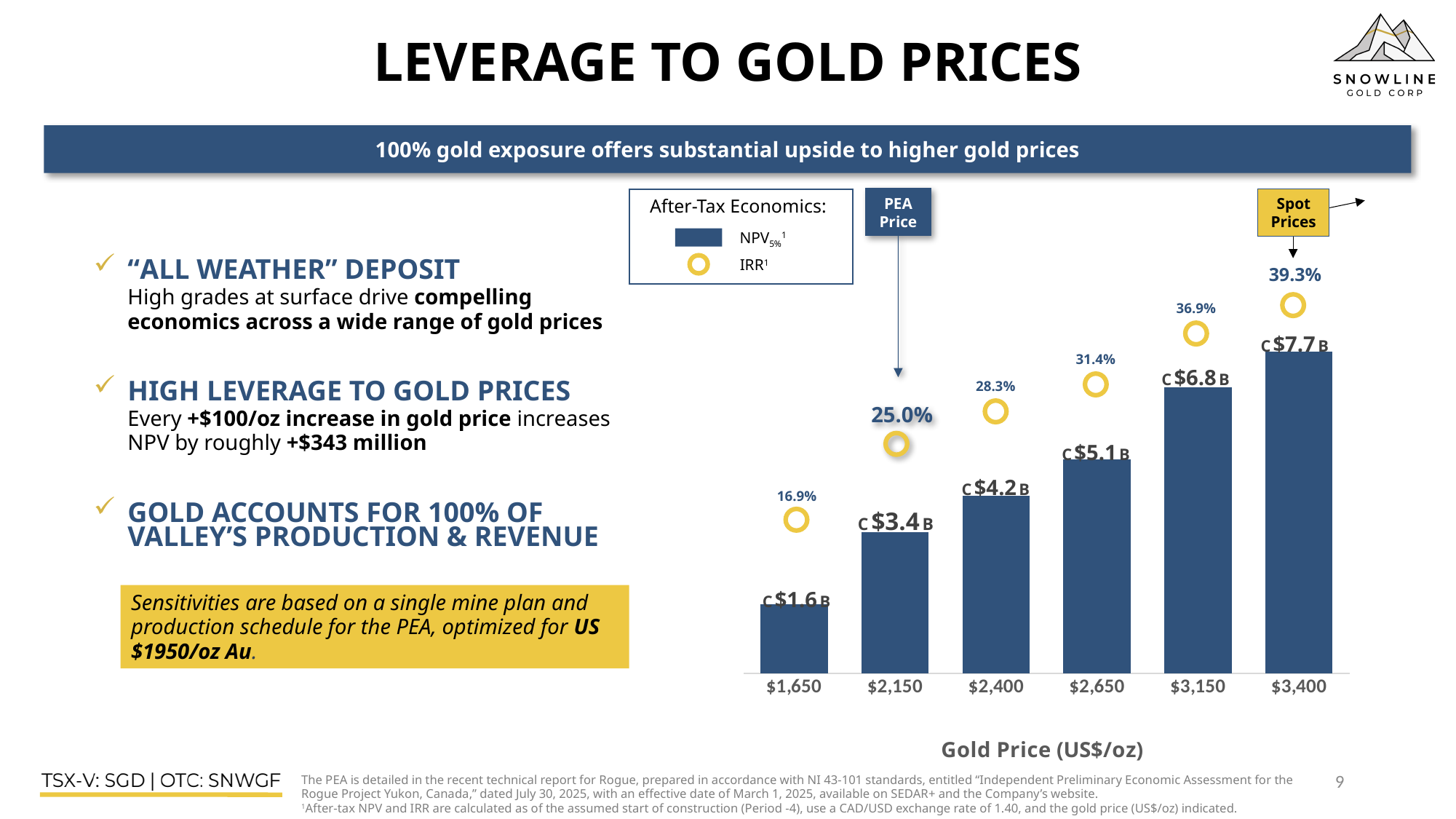
Do NPV values rise or fall as the gold price increases along the x axis? Rise How many series does the legend list? 2 At which gold price is the IRR lowest? $1,650 What is the NPV at a gold price of $1,650/oz? C$1.6B At which gold price is the NPV highest? $3,400 How many gold price scenarios are shown on the x axis? 6 What is the NPV at a gold price of $2,150/oz? C$3.4B What is the IRR at a gold price of $2,650/oz? 31.4% Which is larger, the NPV at $2,400/oz or the NPV at $2,650/oz? $2,650/oz What is the difference in NPV between the $3,400/oz and $3,150/oz gold price cases? C$0.9B What kind of chart is used to show NPV? Bar chart What is the IRR at a gold price of $3,400/oz? 39.3%